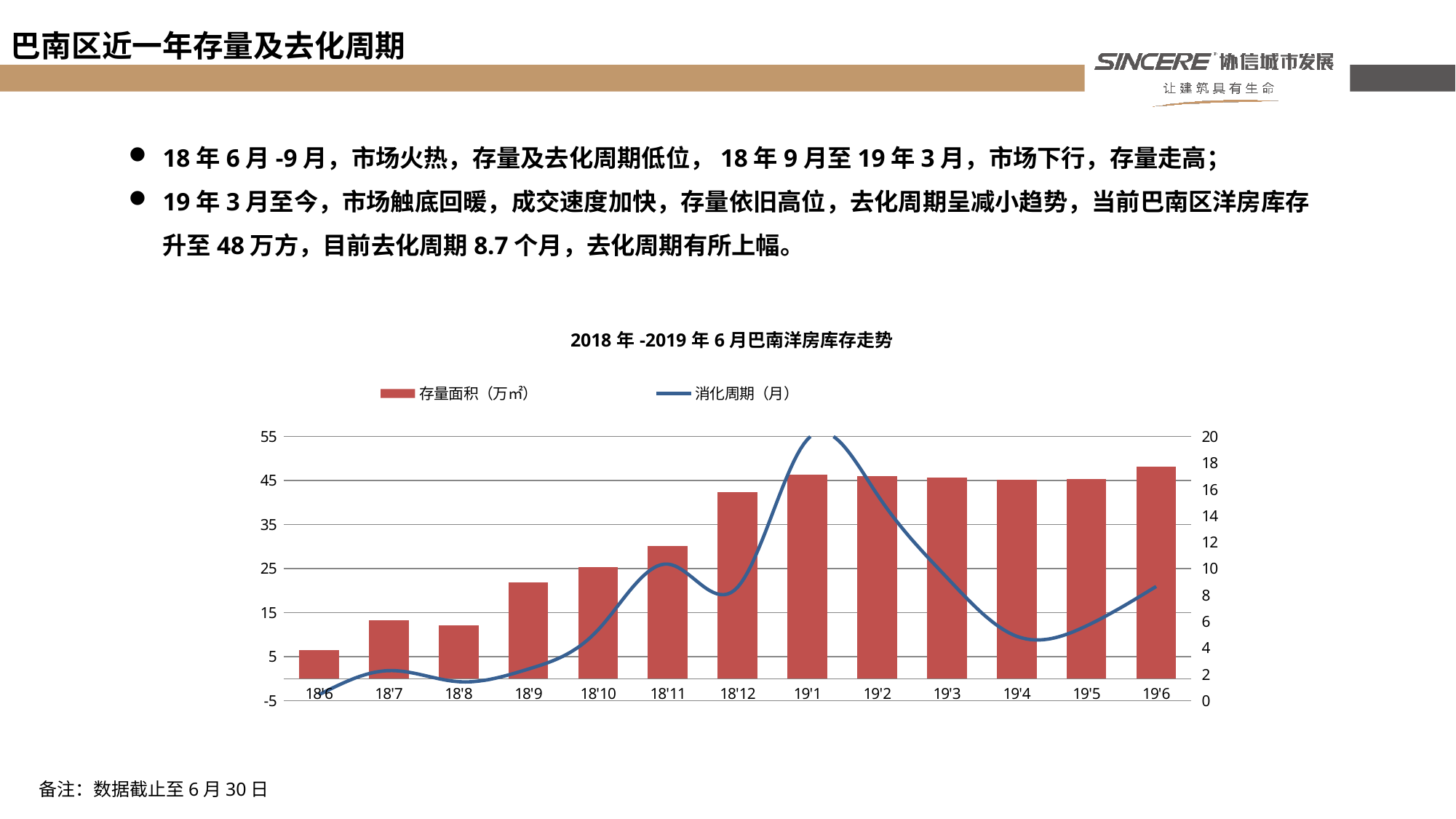
How many series does the chart legend list? 2 Which month has the highest 存量面积 bar? 19'6 Is the 消化周期 value for 19'4 greater or less than 6? less Is the 存量面积 value for 18'9 greater or less than 25? less Which month has the larger 存量面积 bar, 18'11 or 18'12? 18'12 How many months (categories) are shown on the x axis of the chart? 13 Do the 存量面积 bars generally rise or fall from 18'6 to 19'6? rise In which month does the 消化周期 line reach its peak? 19'1 What kind of chart is shown on the slide? Combined bar and line chart Is the 消化周期 value for 18'11 greater or less than 8? greater Which month has the lowest 存量面积 bar? 18'6